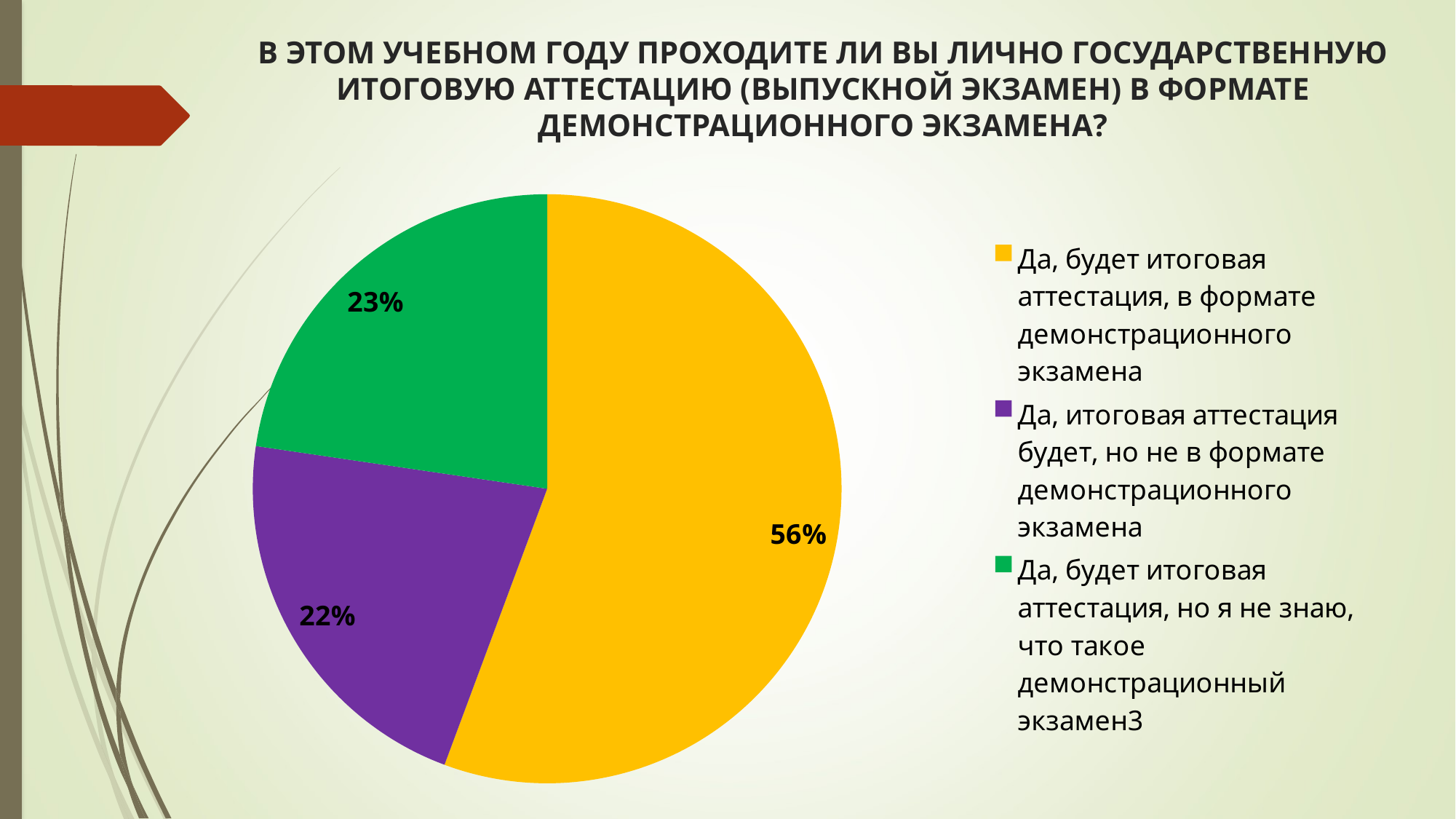
How many entries does the legend list? 3 What share of respondents answered "Да, будет итоговая аттестация, но я не знаю, что такое демонстрационный экзамен"? 23% How many slices does the pie chart have? 3 Which is larger: the share for "Да, будет итоговая аттестация, но я не знаю, что такое демонстрационный экзамен" or the share for "Да, итоговая аттестация будет, но не в формате демонстрационного экзамена"? Да, будет итоговая аттестация, но я не знаю, что такое демонстрационный экзамен What share of respondents answered "Да, будет итоговая аттестация, в формате демонстрационного экзамена"? 56% What colour is the slice representing 23%? green What share of respondents answered "Да, итоговая аттестация будет, но не в формате демонстрационного экзамена"? 22% What kind of chart is shown on the slide? pie chart What is the difference in percentage points between the largest slice (56%) and the purple slice (22%)? 34 What colour is the slice representing 56%? yellow Which answer option has the largest share of the pie? Да, будет итоговая аттестация, в формате демонстрационного экзамена Which answer option has the smallest share of the pie? Да, итоговая аттестация будет, но не в формате демонстрационного экзамена